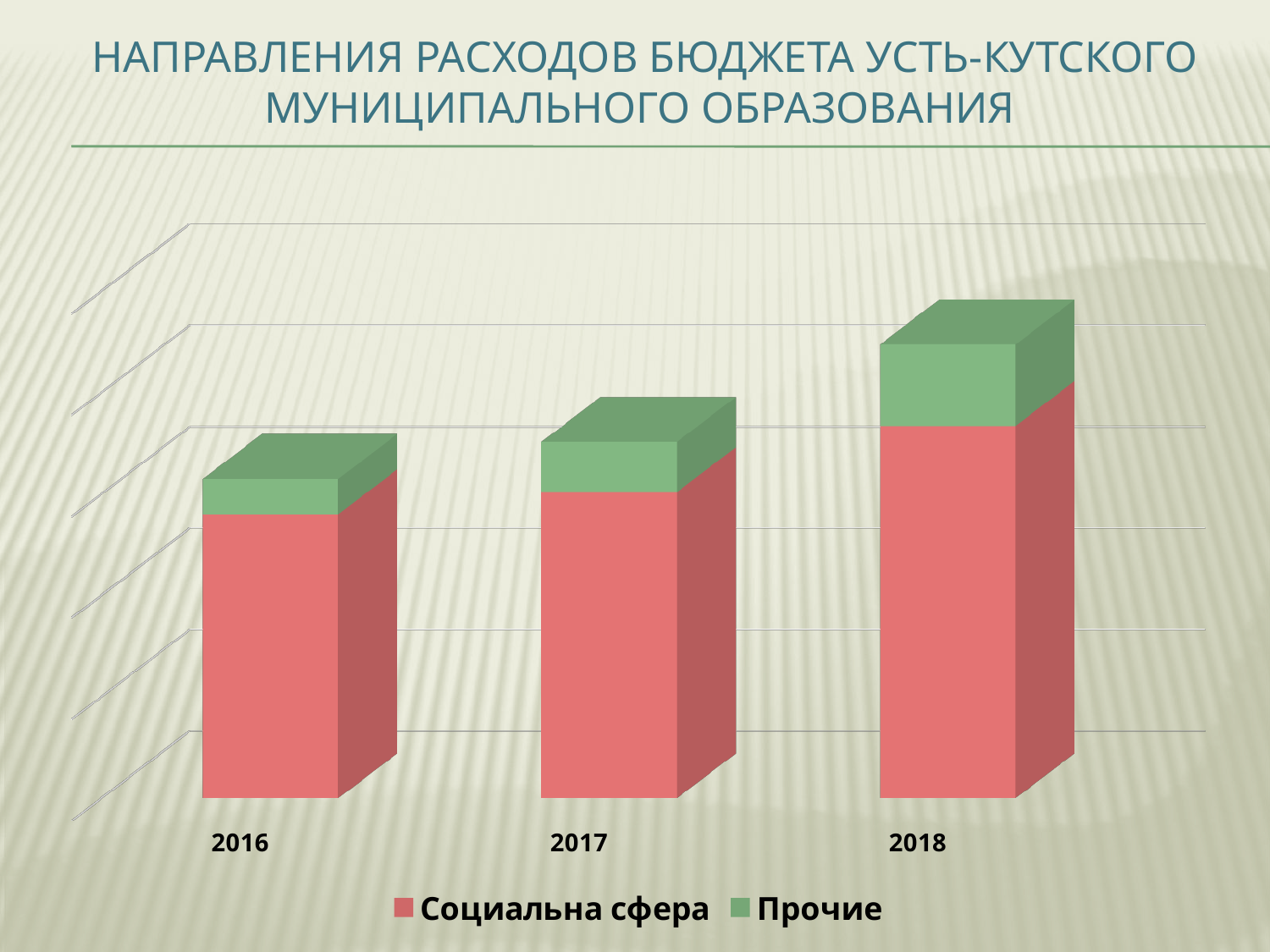
How many series does the legend list? 2 Which series is shown in green? Прочие Is the Социальна сфера segment larger in 2017 or in 2016? 2017 Which year has the shortest stacked bar? 2016 Which year has the tallest stacked bar? 2018 Do the total bar heights rise or fall from 2016 to 2018? Rise How many years (categories) are shown on the x axis? 3 Which series is shown in red? Социальна сфера What kind of chart is shown on the slide? Bar chart Is the total bar for 2018 larger or smaller than the total bar for 2016? Larger In each bar, which series forms the larger segment? Социальна сфера Which year is the first category on the x axis? 2016